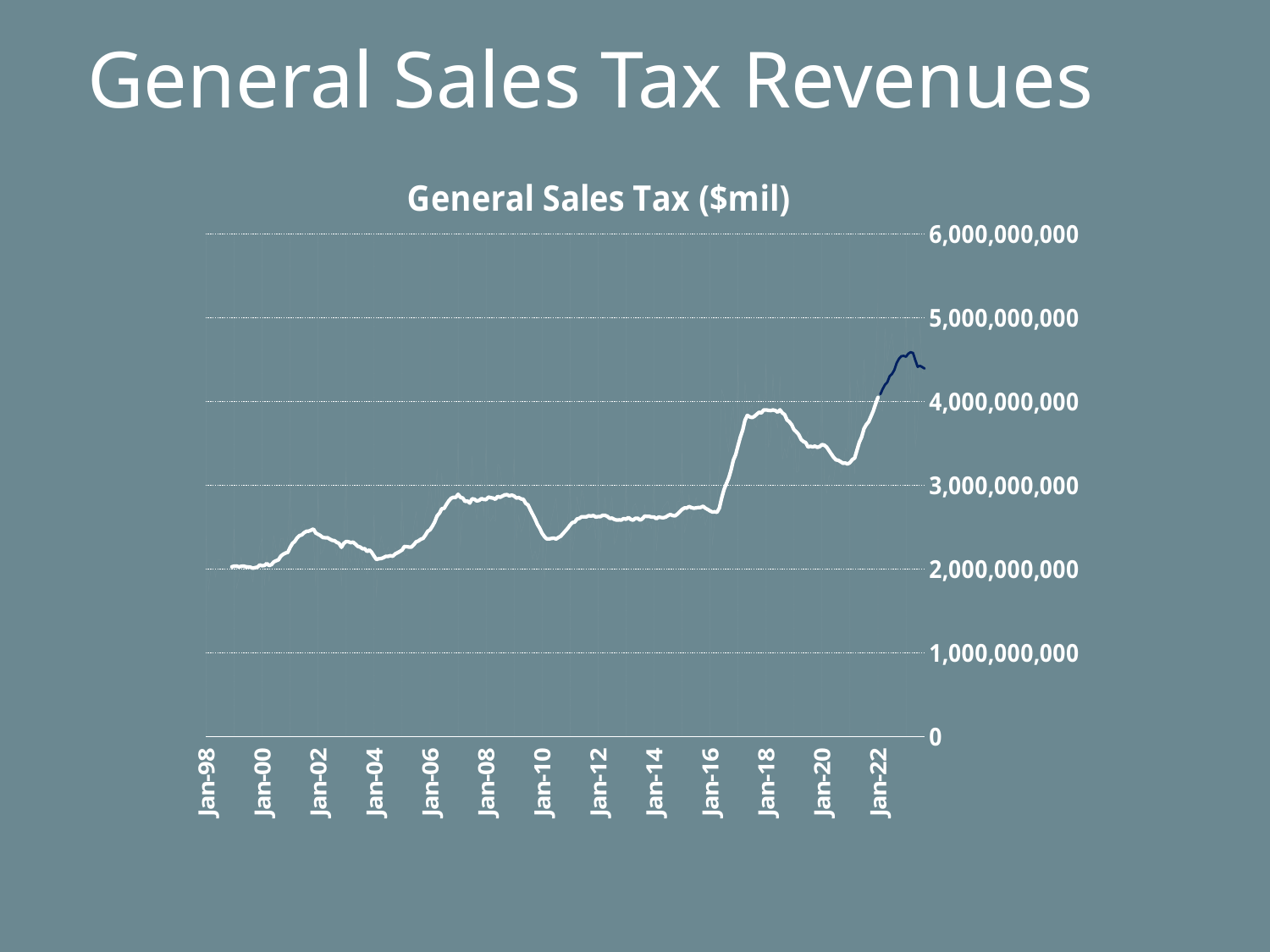
Do the values rise or fall between Jan-18 and Jan-20? fall What kind of chart is shown on the slide? line chart Is the value at Jan-20 greater or less than 4,000,000,000? less Is the value at Jan-10 greater or less than 3,000,000,000? less How many date labels are shown along the horizontal axis? 13 Is the value at Jan-06 greater or less than 3,000,000,000? less What is the highest value labelled on the vertical axis? 6,000,000,000 Which is larger, the value at Jan-22 or the value at Jan-98? Jan-22 Overall, do the values rise or fall from Jan-98 to Jan-22? rise What is the title of the chart? General Sales Tax ($mil)